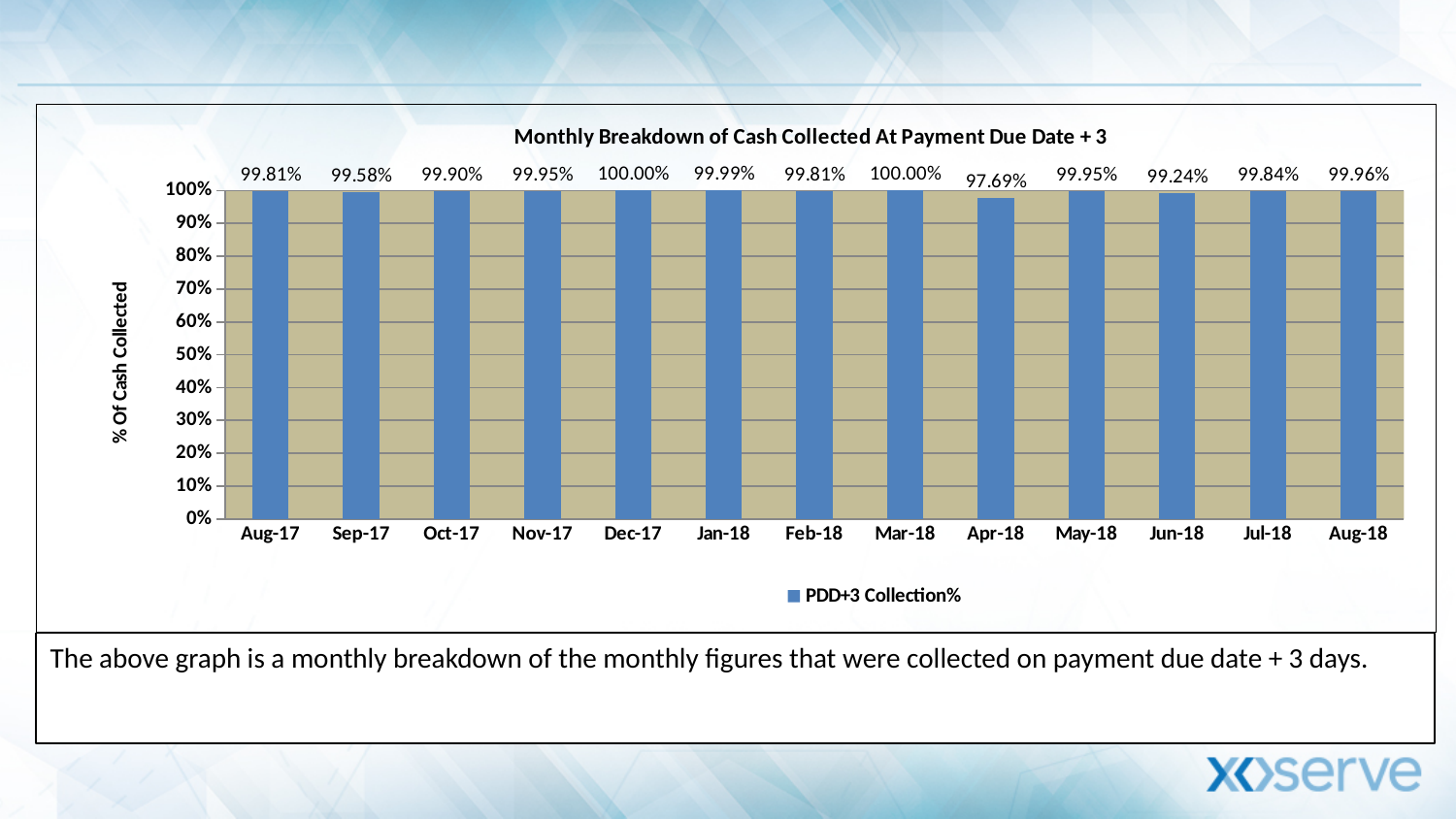
Which has a higher PDD+3 Collection%, Apr-18 or Jun-18? Jun-18 What is the difference between the PDD+3 Collection% for Dec-17 and Apr-18? 2.31% How many months are shown on the x axis of the chart? 13 What is the title of the chart? Monthly Breakdown of Cash Collected At Payment Due Date + 3 What is the PDD+3 Collection% value for Jun-18? 99.24% Which month has the lowest PDD+3 Collection%? Apr-18 Which months reach a PDD+3 Collection% of 100.00%? Dec-17 and Mar-18 What type of chart is shown on the slide? Bar chart What is the PDD+3 Collection% value for Apr-18? 97.69% What is the PDD+3 Collection% value for Sep-17? 99.58% What is the difference between the PDD+3 Collection% for Mar-18 and Jun-18? 0.76% What is the PDD+3 Collection% value for Aug-18? 99.96%